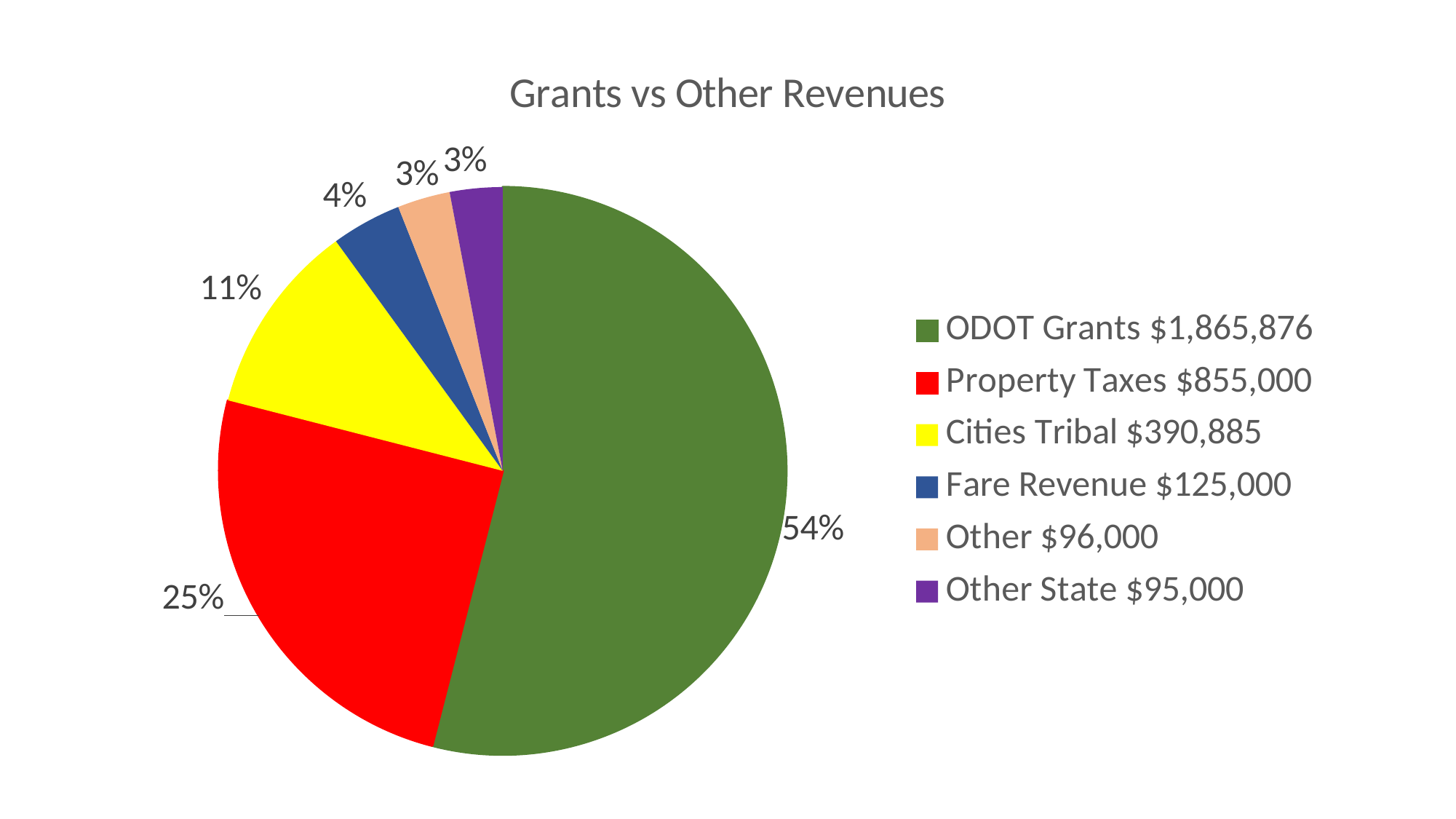
What percentage of the pie does Cities Tribal represent? 11% Which is larger, Cities Tribal or Fare Revenue? Cities Tribal What is the dollar value shown for Cities Tribal in the legend? $390,885 Which category has the largest share of the pie? ODOT Grants How many slices does the pie chart have? 6 What is the dollar value shown for Fare Revenue in the legend? $125,000 What is the difference in dollar value between ODOT Grants and Property Taxes? $1,010,876 What percentage of the pie does ODOT Grants represent? 54% Which category has the smallest dollar value in the legend? Other State What percentage of the pie does Property Taxes represent? 25% What type of chart is shown on the slide? pie chart What is the title of the chart? Grants vs Other Revenues